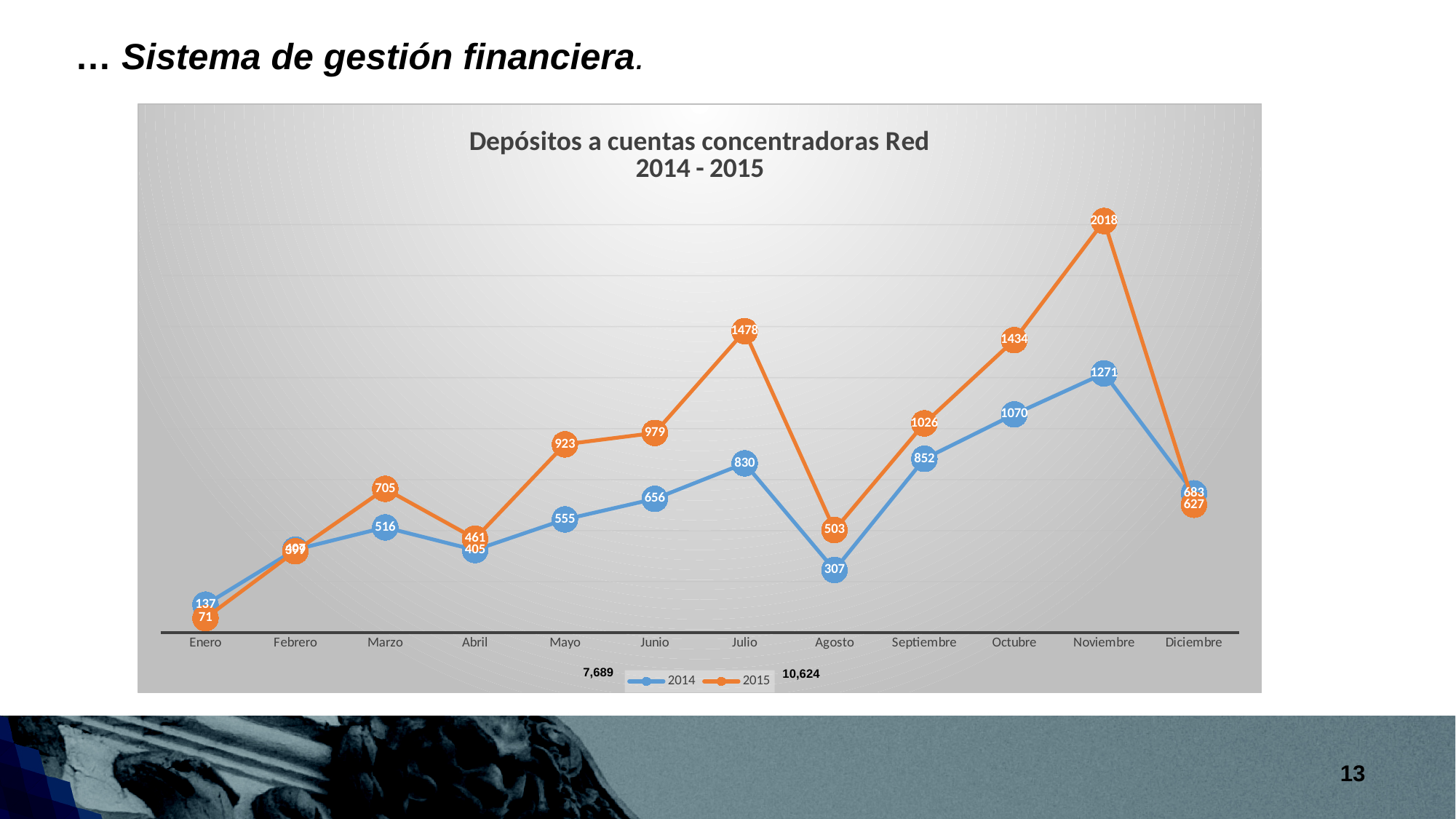
What is the value for 2015 in Agosto? 503 In which month is the 2015 series highest? Noviembre Does the 2015 series rise or fall from Agosto to Noviembre? Rise Which series has the larger value in Diciembre, 2014 or 2015? 2014 What is the title of the chart? Depósitos a cuentas concentradoras Red 2014 - 2015 What type of chart is shown on the slide? Line chart What is the value for 2015 in Noviembre? 2018 How many months are shown on the x axis? 12 What is the difference between the 2015 and 2014 values in Julio? 648 What is the value for 2014 in Julio? 830 How many series does the legend list? 2 In which month is the 2014 series lowest? Enero